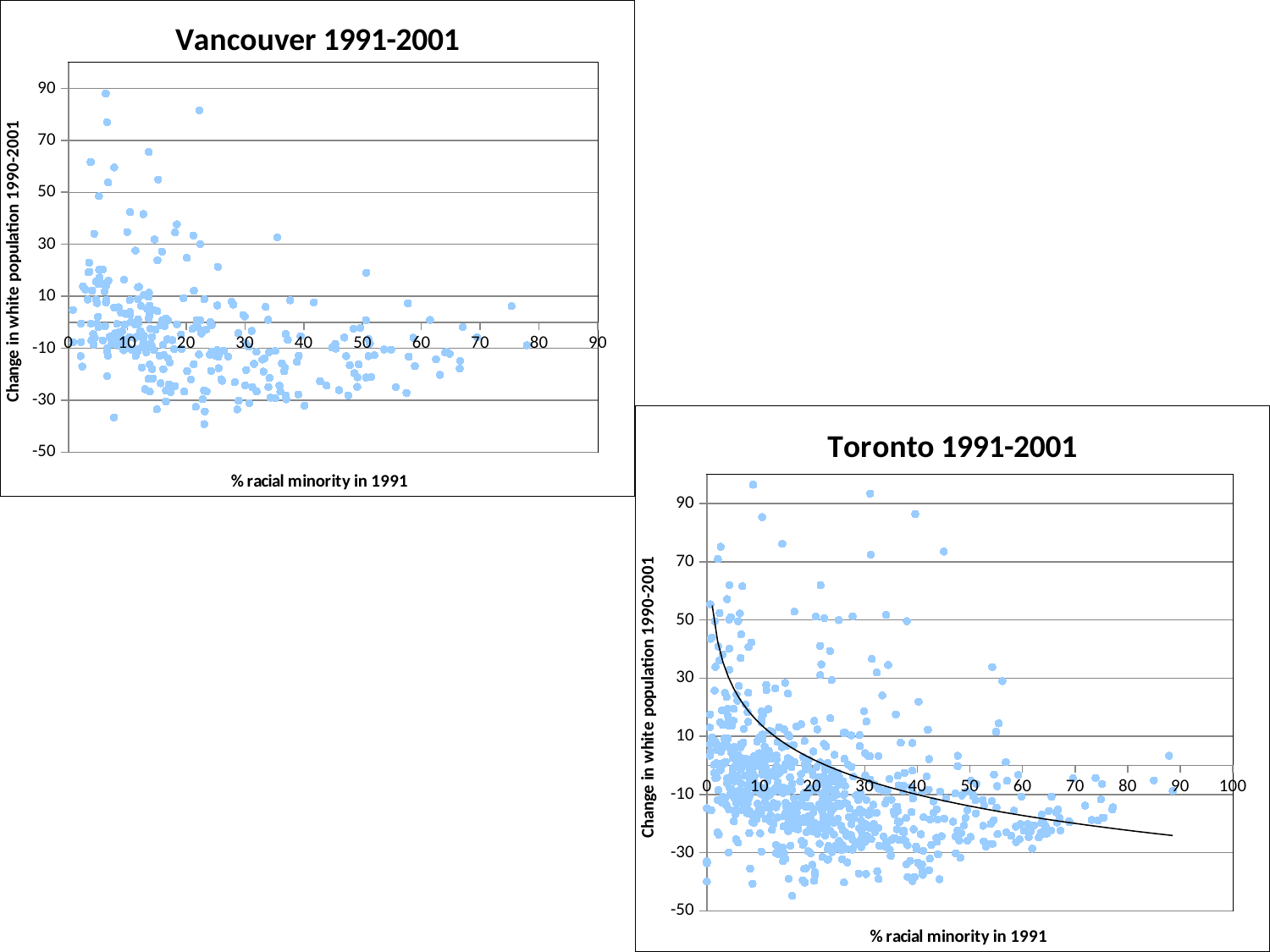
What is the x-axis label of the "Vancouver 1991-2001" chart? % racial minority in 1991 What is the highest x-axis tick value shown on the "Toronto 1991-2001" chart? 100 In the "Toronto 1991-2001" chart, does the fitted curve rise or fall as % racial minority in 1991 increases? fall What is the lowest y-axis tick value shown on the "Vancouver 1991-2001" chart? -50 What kind of chart is the "Vancouver 1991-2001" chart? scatter chart What is the y-axis label of the "Toronto 1991-2001" chart? Change in white population 1990-2001 What kind of chart is the "Toronto 1991-2001" chart? scatter chart In the "Vancouver 1991-2001" chart, do the changes in white population generally rise or fall as % racial minority in 1991 increases? fall How many charts are shown on the slide? 2 Which of the two charts includes a fitted trend curve? Toronto 1991-2001 What is the highest x-axis tick value shown on the "Vancouver 1991-2001" chart? 90